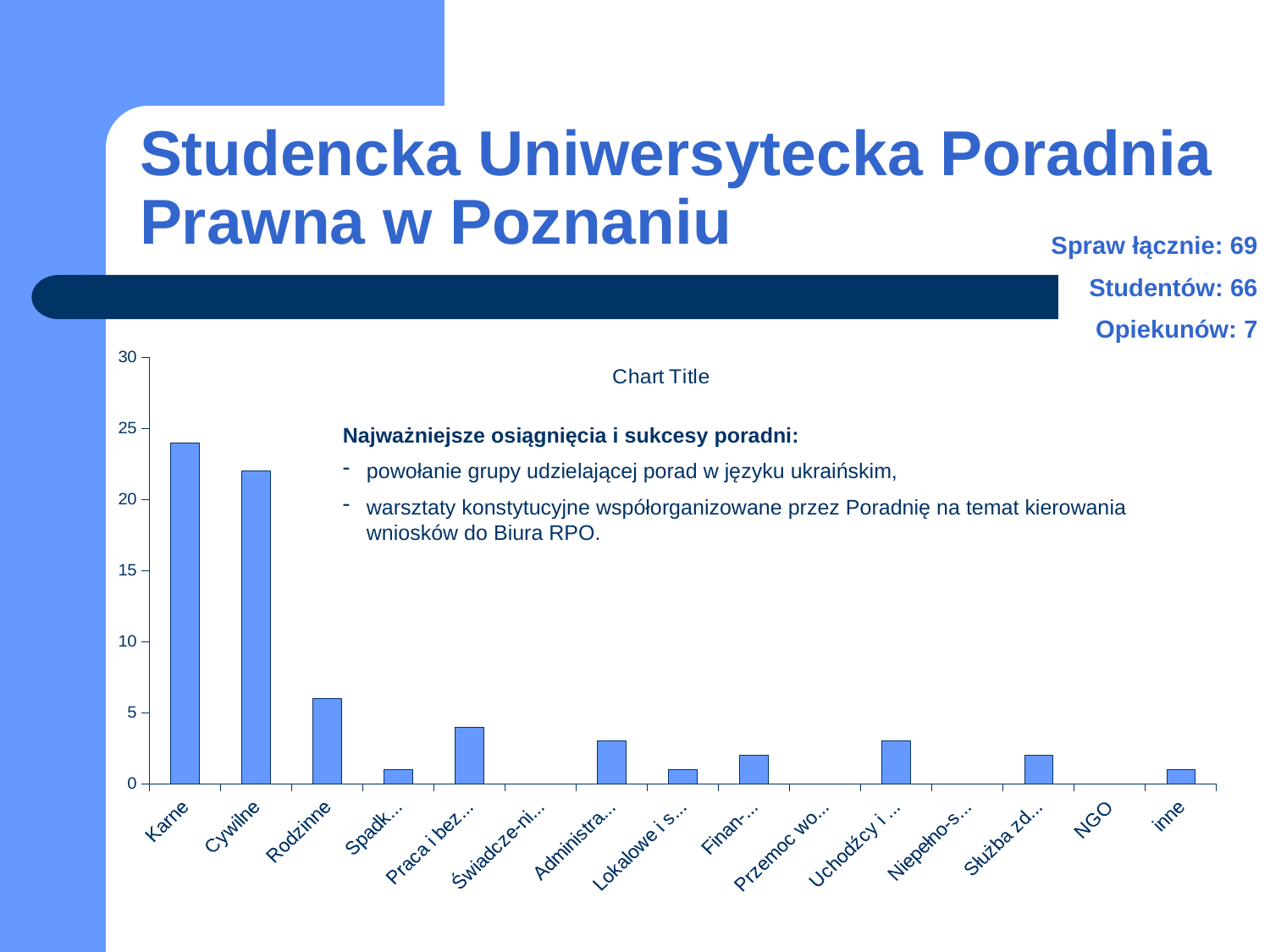
Is the value for Cywilne greater or less than 20? greater What is the title shown on the chart? Chart Title Is the value for Rodzinne greater or less than 10? less Which is larger, the value for Karne or the value for Rodzinne? Karne Is the value for NGO greater or less than 5? less How many categories are shown on the x axis of the chart? 15 Which category has the highest value in the chart? Karne Which is larger, the value for Cywilne or the value for inne? Cywilne What kind of chart is shown on the slide? bar chart